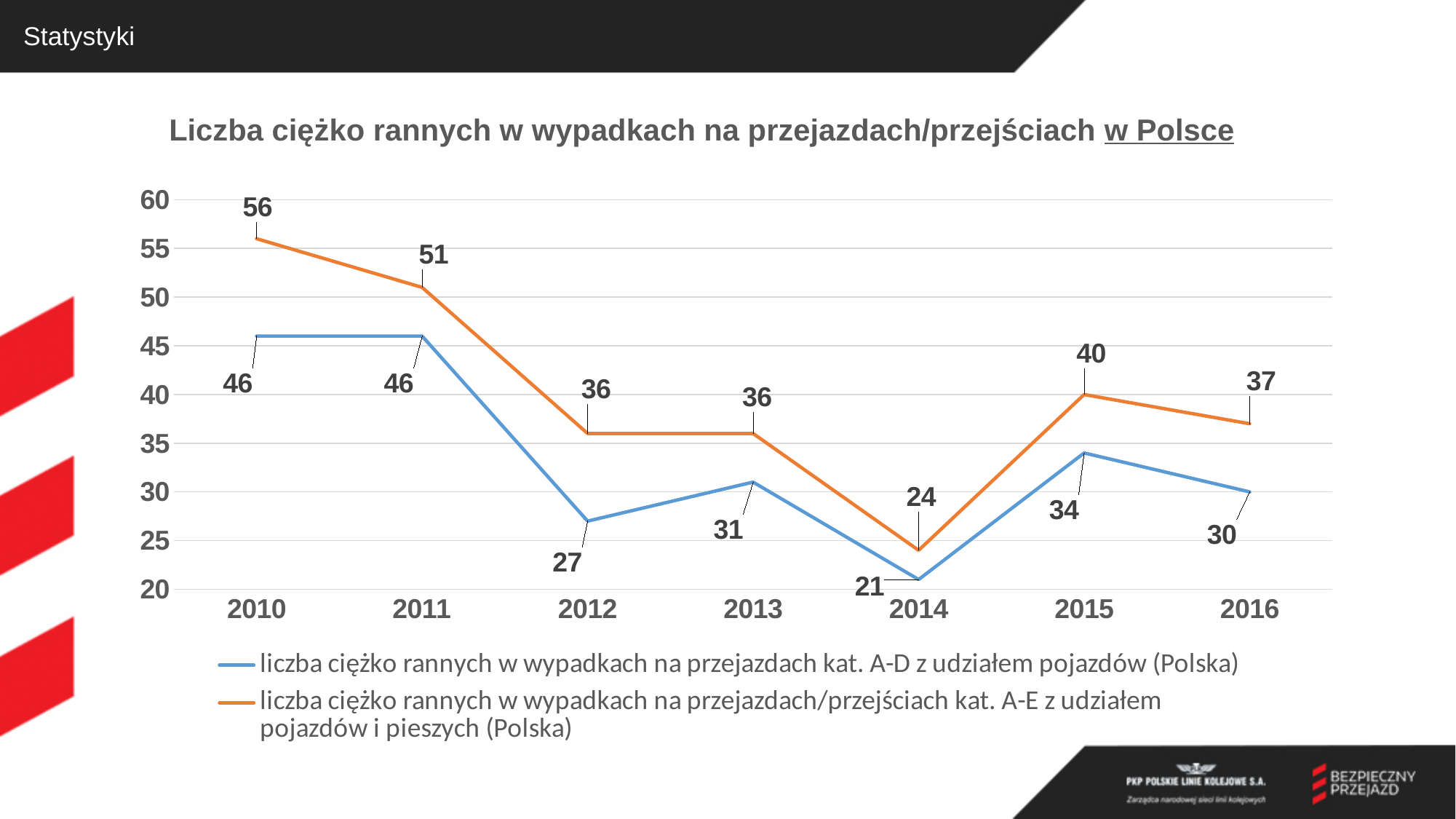
What is the value of the blue series (kat. A-D, pojazdów) in 2016? 30 What is the value of the orange series (kat. A-E, pojazdów i pieszych) in 2010? 56 In which year is the orange series (kat. A-E) at its lowest? 2014 In which year is the blue series (kat. A-D) at its highest? 2010 and 2011 How many series does the legend list? 2 Which is larger: the blue series value in 2013 or in 2012? 2013 What is the difference between the orange and blue series values in 2015? 6 Does the orange series rise or fall from 2010 to 2014? fall What kind of chart is shown on the slide? line chart What is the difference between the orange series values in 2010 and 2016? 19 What is the value of the blue series (kat. A-D, pojazdów) in 2014? 21 How many years are shown on the x axis? 7